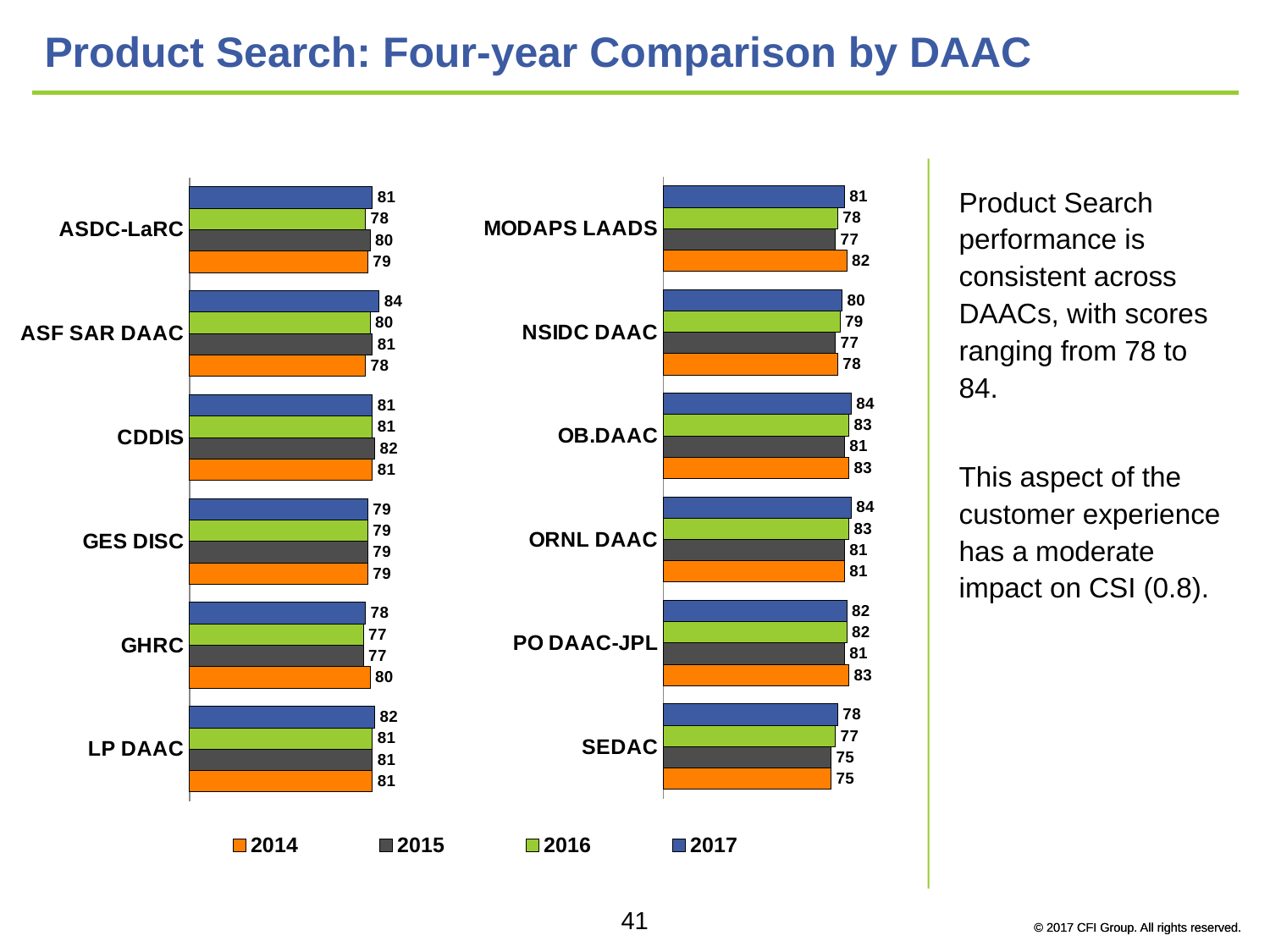
In the left chart, what is the difference between the 2017 and 2014 values for ASF SAR DAAC? 6 In the right chart, which is larger for MODAPS LAADS: the 2014 value or the 2015 value? 2014 In the right chart, what is the 2014 value for SEDAC? 75 Which colour represents 2014 in the legend? Orange In the left chart, which DAAC has the highest 2017 value? ASF SAR DAAC In the left chart, what is the 2017 value for ASF SAR DAAC? 84 In the right chart, which DAAC has the lowest 2017 value? SEDAC In the left chart, what is the 2016 value for GHRC? 77 What kind of chart is used on this slide? Bar chart How many series does the legend list? 4 How many DAACs are shown in the right chart? 6 In the right chart, what is the 2015 value for NSIDC DAAC? 77